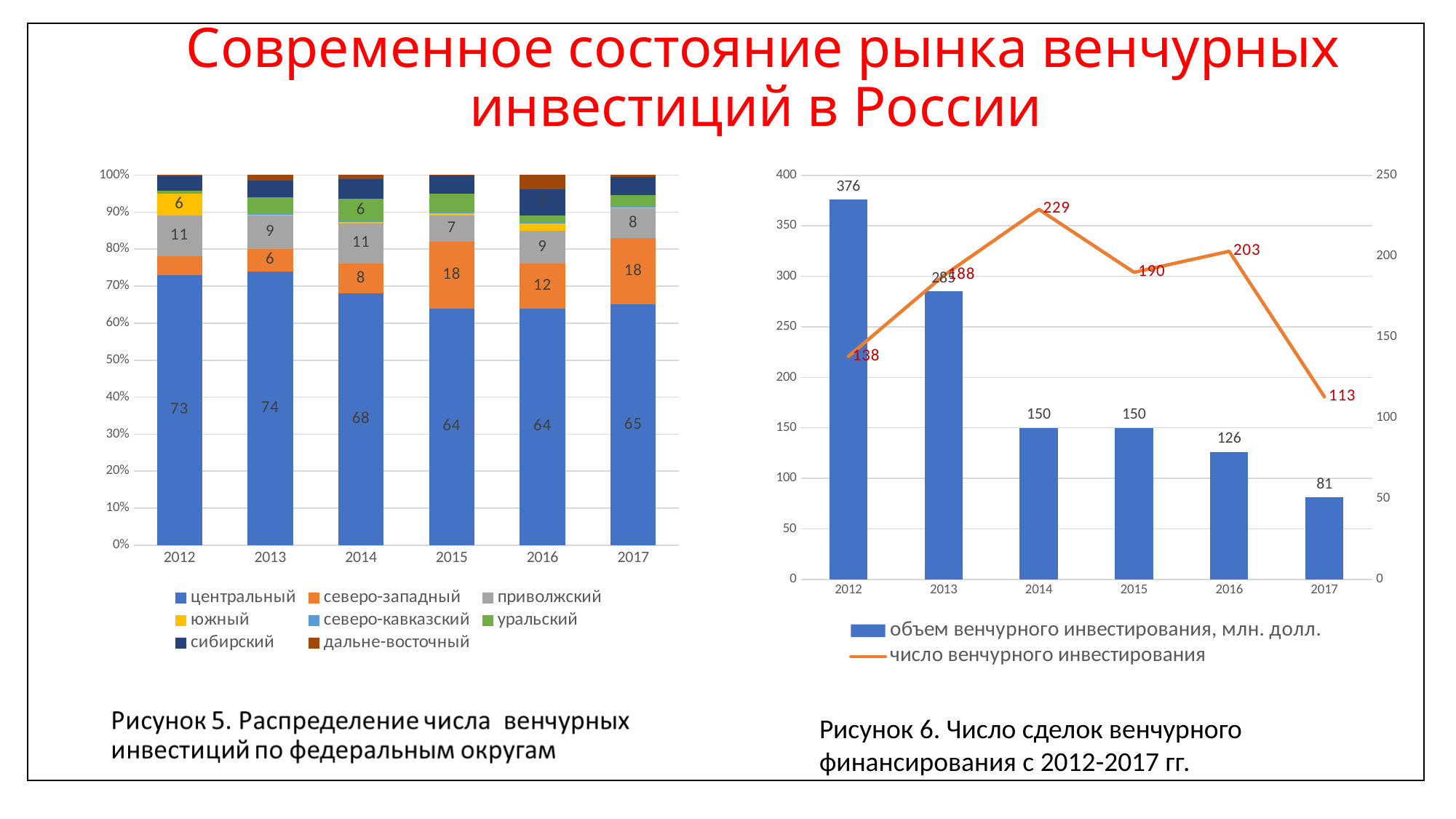
In the right chart (Рисунок 6), how many years are shown on the x axis? 6 In the right chart (Рисунок 6), what is the объем венчурного инвестирования for 2012? 376 In the right chart (Рисунок 6), is the число венчурного инвестирования larger in 2016 or in 2017? 2016 In the right chart (Рисунок 6), which year has the lowest объем венчурного инвестирования? 2017 In the left chart (Рисунок 5), what is the value for центральный in 2012? 73 In the left chart (Рисунок 5), which year has the highest value for центральный? 2013 In the right chart (Рисунок 6), what is the число венчурного инвестирования for 2014? 229 In the right chart (Рисунок 6), what is the difference between the объем венчурного инвестирования for 2016 and 2017? 45 In the left chart (Рисунок 5), what is the difference between the центральный values for 2013 and 2015? 10 In the left chart (Рисунок 5), what is the value for приволжский in 2014? 11 In the left chart (Рисунок 5), how many series does the legend list? 8 In the left chart (Рисунок 5), what is the value for северо-западный in 2015? 18